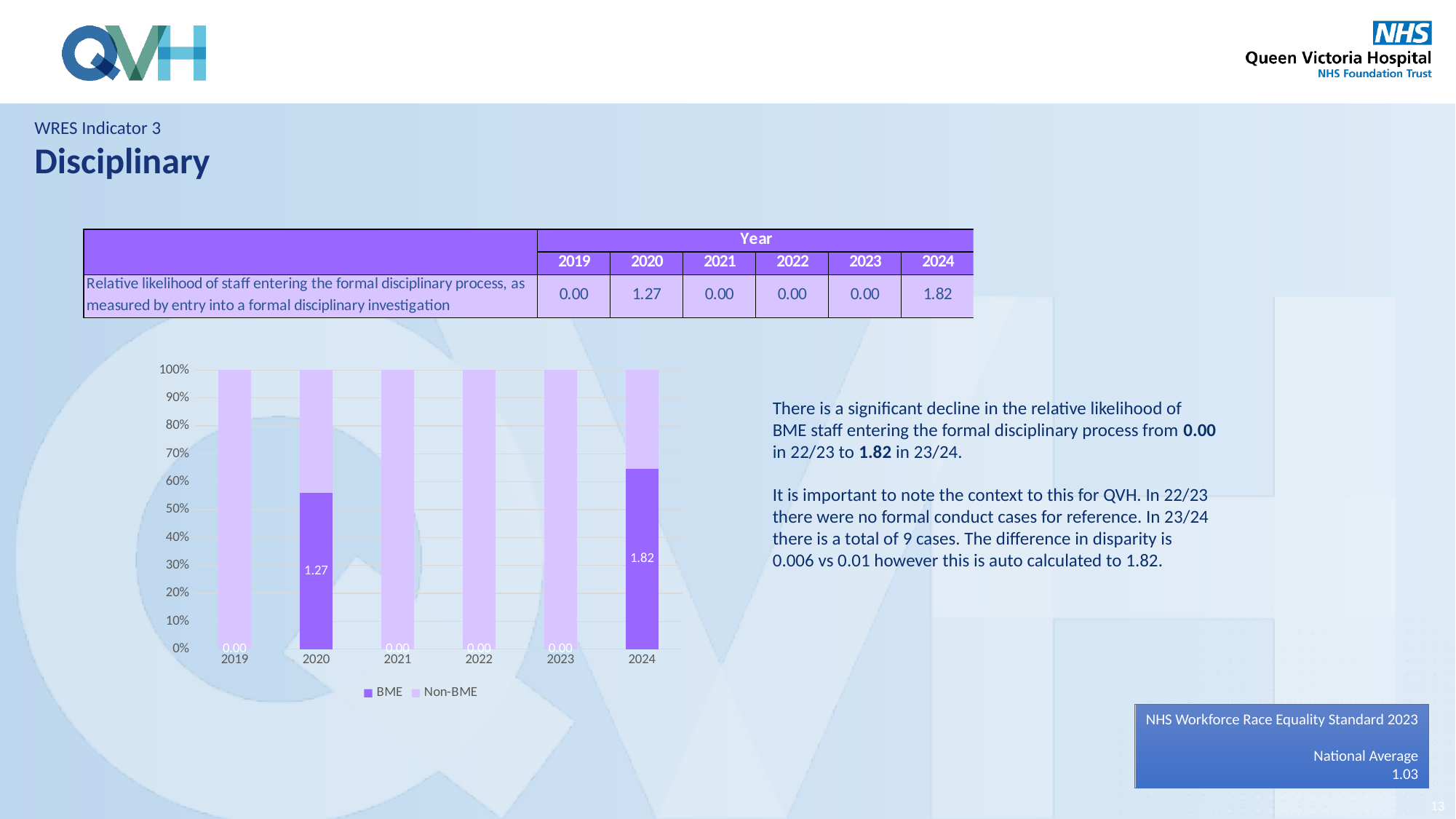
How many series does the chart legend list? 2 What is the BME data label for 2020 in the chart? 1.27 What is the BME data label for 2023 in the chart? 0.00 How many years are shown on the x axis of the chart? 6 Is the BME share of the 2020 bar greater or less than 70%? less What is the difference between the BME values for 2024 and 2020? 0.55 Is the BME share of the 2024 bar greater or less than 50%? greater Which is larger, the BME value for 2020 or for 2024? 2024 Which year has the highest BME value in the chart? 2024 What is the BME data label for 2024 in the chart? 1.82 What kind of chart is shown on the slide? Stacked bar chart What are the two series named in the chart legend? BME and Non-BME